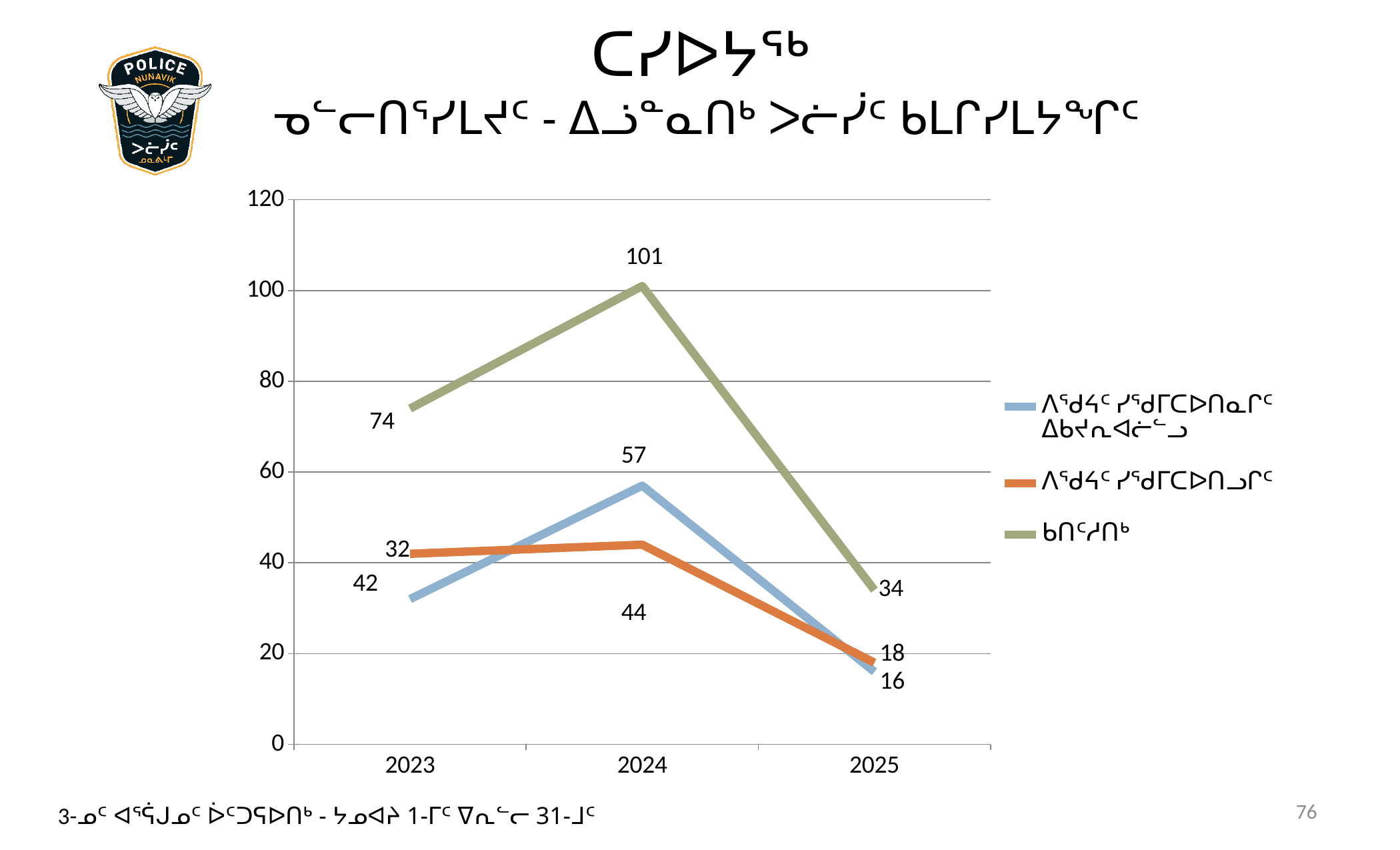
What is the value of the green line (ᑲᑎᑦᓱᑎᒃ) in 2023? 74 In 2024, which is larger, the blue line or the orange line? blue line In which year does the green line (ᑲᑎᑦᓱᑎᒃ) reach its highest value? 2024 In which year does the green line (ᑲᑎᑦᓱᑎᒃ) have its lowest value? 2025 Does the green line (ᑲᑎᑦᓱᑎᒃ) rise or fall from 2024 to 2025? fall How many years are shown on the x axis? 3 What is the value of the green line (ᑲᑎᑦᓱᑎᒃ) in 2024? 101 What is the value of the blue line in 2024? 57 By how much does the green line (ᑲᑎᑦᓱᑎᒃ) drop from 2024 to 2025? 67 What is the value of the green line (ᑲᑎᑦᓱᑎᒃ) in 2025? 34 How many series does the legend list? 3 What kind of chart is shown on the slide? line chart